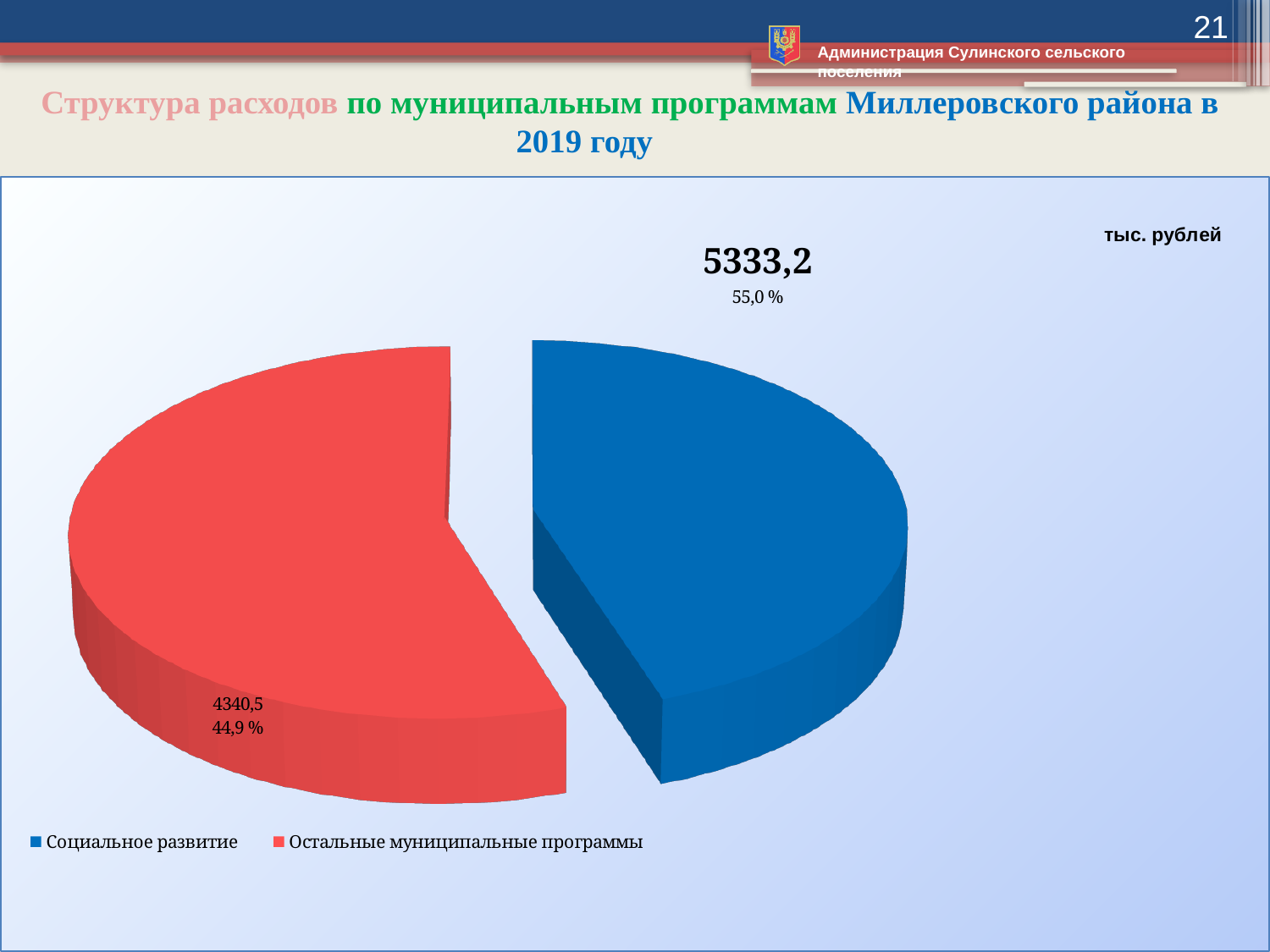
What is the value for Социальное развитие? 4340,5 How many slices does the pie chart have? 2 What share of the pie does Остальные муниципальные программы take? 55,0 % Which category has the smallest slice? Социальное развитие What unit is indicated for the values on the chart? тыс. рублей Which category has the largest slice? Остальные муниципальные программы What is the value for Остальные муниципальные программы? 5333,2 Which is larger, Социальное развитие or Остальные муниципальные программы? Остальные муниципальные программы What share of the pie does Социальное развитие take? 44,9 % What colour is the slice for Остальные муниципальные программы? red What is the difference between the values for Социальное развитие and Остальные муниципальные программы? 992,7 What kind of chart is shown on the slide? pie chart